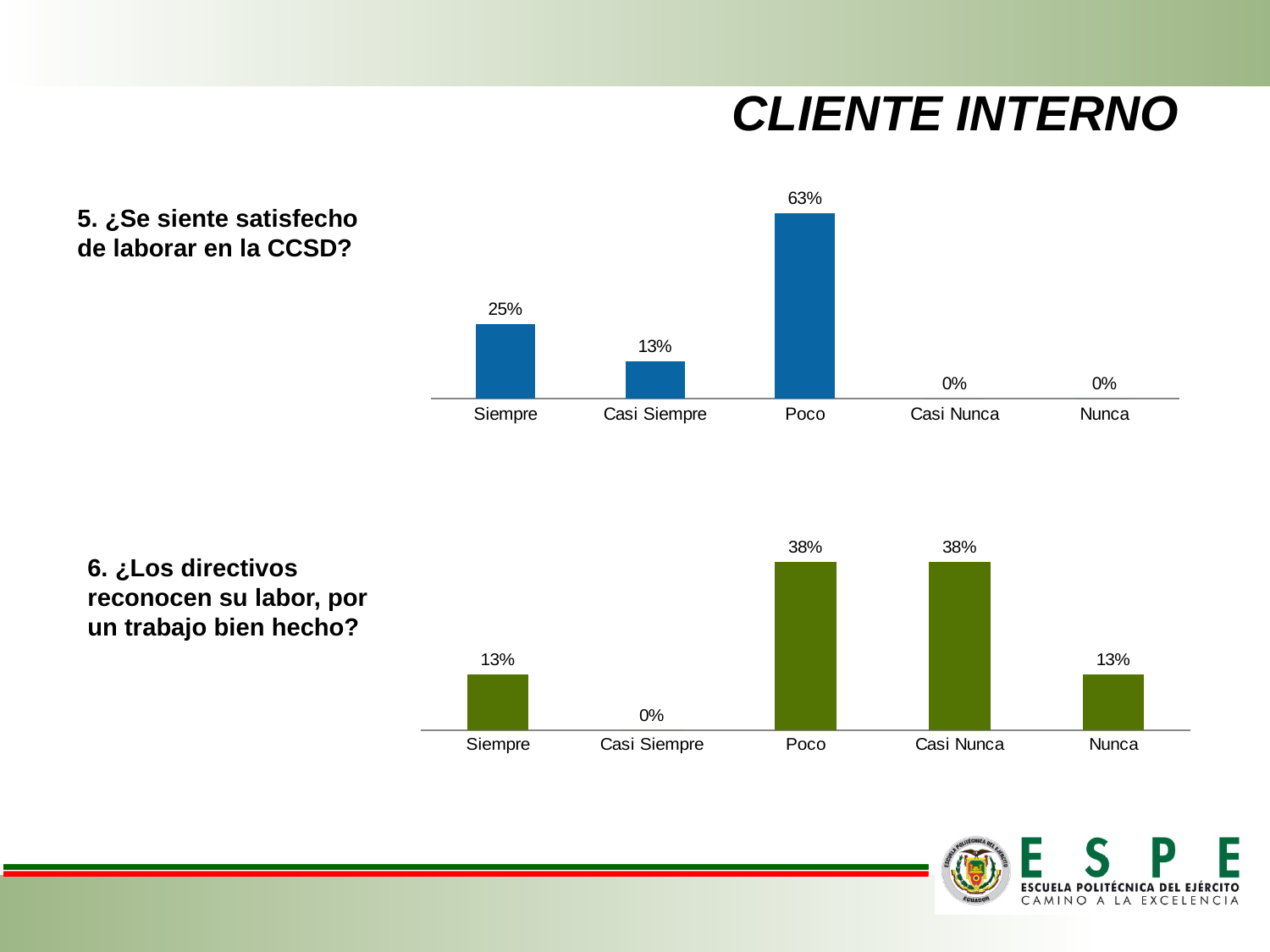
In the bottom chart (question 6), which category has the lowest value? Casi Siempre In the top chart (question 5, satisfaction working at CCSD), what is the value for Poco? 63% In the top chart (question 5), which is larger, Siempre or Casi Siempre? Siempre In the top chart (question 5), which category has the highest value? Poco In the top chart (question 5), what is the difference between Poco and Siempre? 38% What colour are the bars in the top chart (question 5)? Blue In the bottom chart (question 6), what is the value for Casi Siempre? 0% In the bottom chart (question 6, managers recognizing work), what is the value for Casi Nunca? 38% What type of chart is the bottom chart (question 6)? Bar chart In the top chart (question 5), what is the value for Siempre? 25% In the top chart (question 5), how many categories are shown on the x axis? 5 In the bottom chart (question 6), what is the difference between Poco and Nunca? 25%